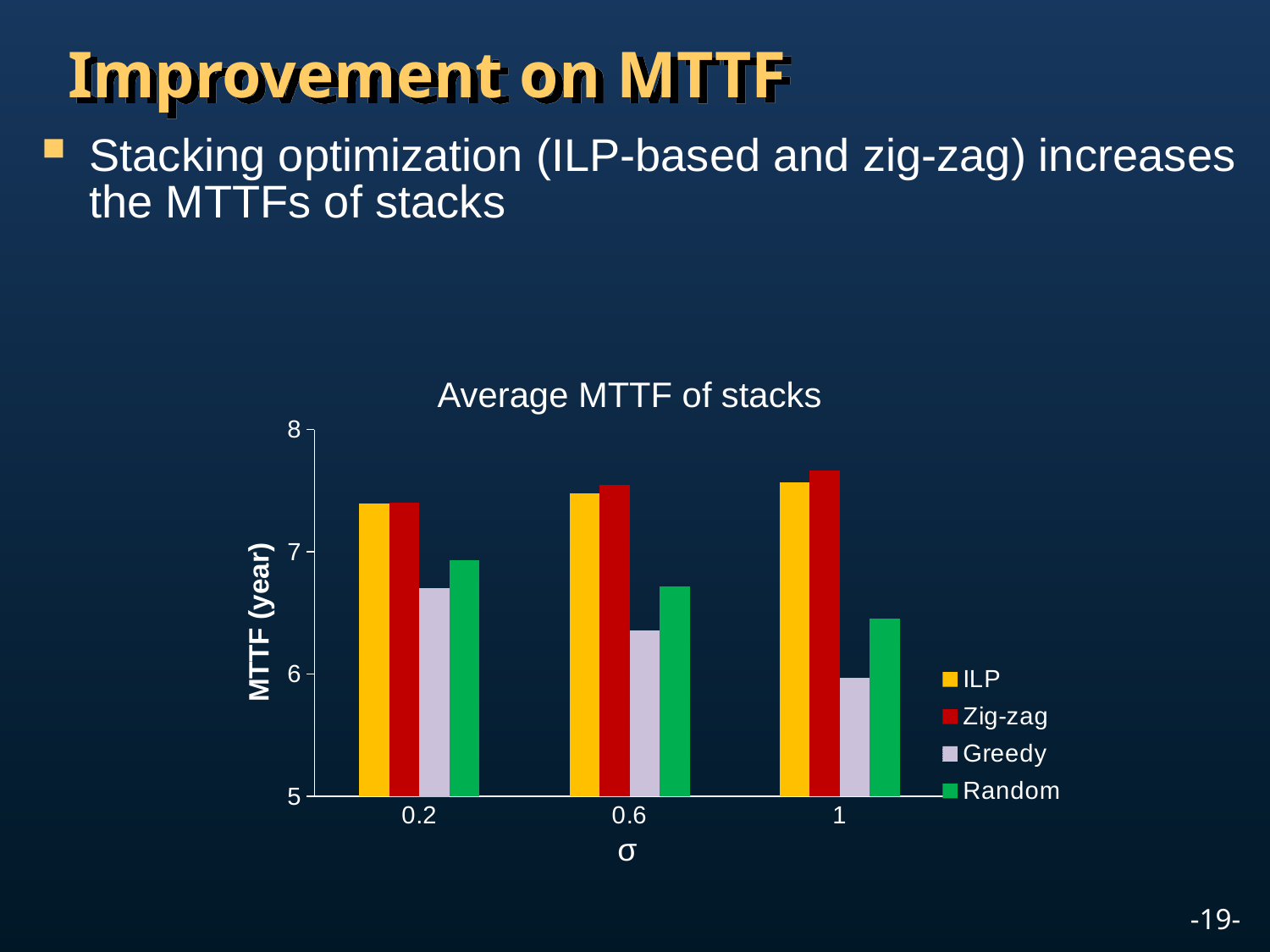
Is the Random value at σ = 0.2 greater or less than 7? less What is the label of the vertical axis of the chart? MTTF (year) Is the ILP value at σ = 0.2 greater or less than 7? greater At σ = 0.6, which is larger: the Greedy value or the Random value? Random How many σ values are shown along the x axis of the chart? 3 Does the Greedy series rise or fall as σ increases from 0.2 to 1? Falls What is the title of the chart? Average MTTF of stacks Is the Greedy value at σ = 0.6 greater or less than 6? greater What kind of chart is shown on the slide? Bar chart Which series has the lowest value at σ = 1? Greedy How many series does the chart legend list? 4